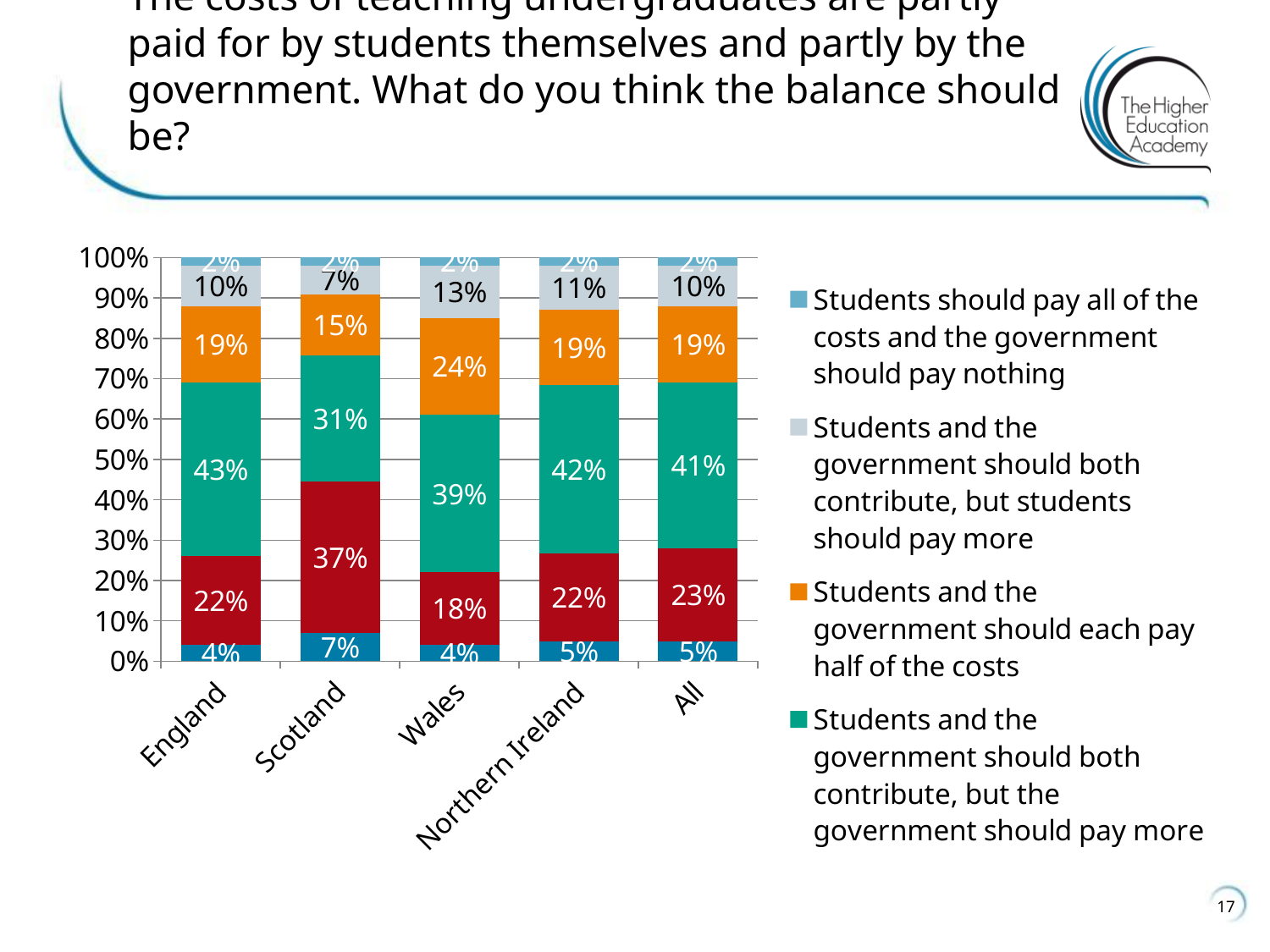
Which category has the highest share saying students should pay more? Wales Which category has the lowest share saying students and the government should each pay half of the costs? Scotland What percentage of respondents in Wales said students and the government should both contribute, but students should pay more? 13% What type of chart is shown on the slide? Stacked bar chart What percentage of respondents in England said students should pay all of the costs and the government should pay nothing? 2% What percentage of respondents in Scotland said students and the government should each pay half of the costs? 15% How many categories are shown on the x axis? 5 Which has a larger share saying students and the government should each pay half: Wales or Northern Ireland? Wales Which category has the highest share saying the government should pay more? England What is the difference between England and Scotland in the share saying the government should pay more? 12 percentage points What colour represents 'Students and the government should each pay half of the costs' in the legend? Orange What percentage of respondents in Wales said students and the government should both contribute, but the government should pay more? 39%